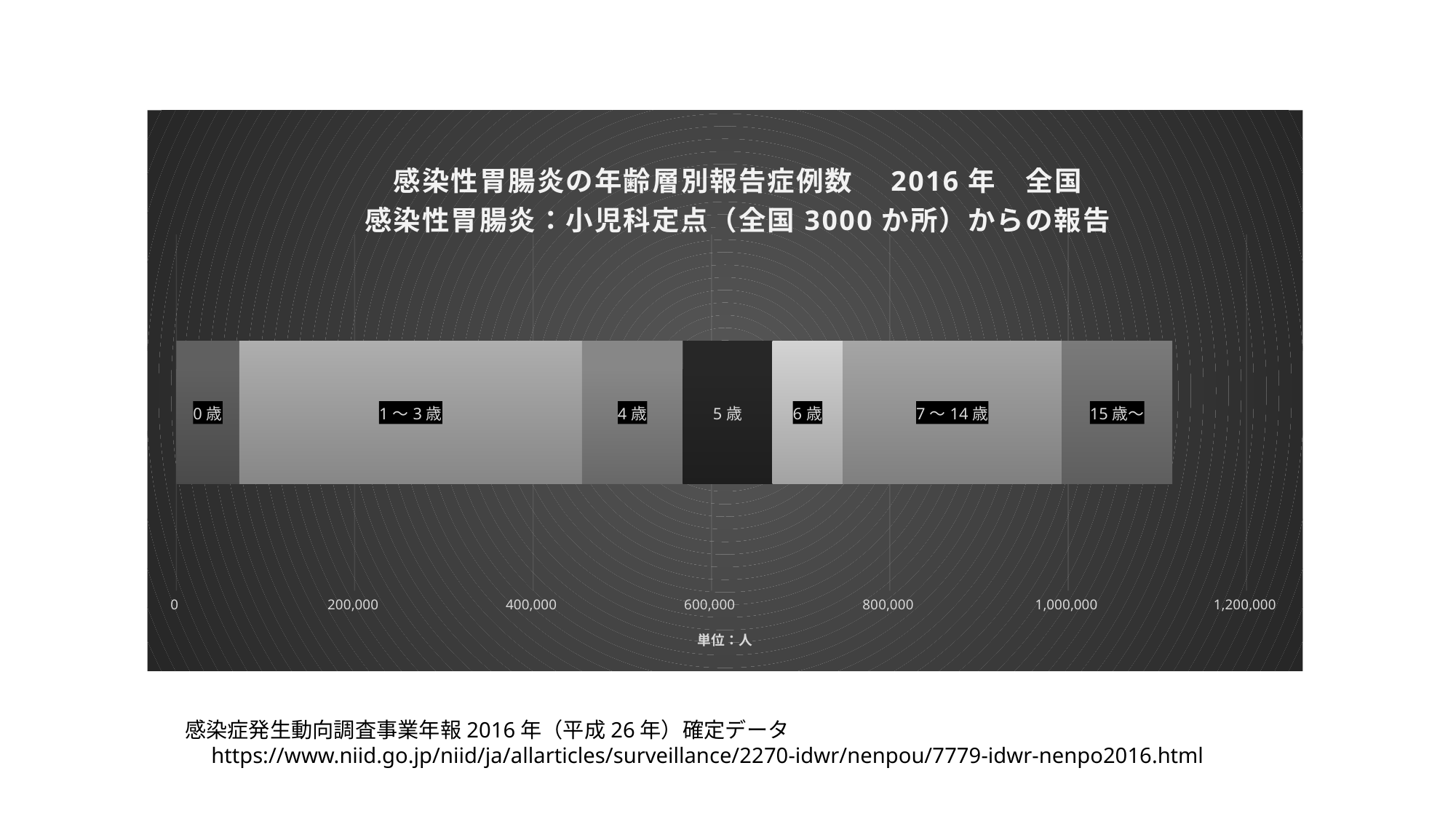
Is the total length of the stacked bar greater or less than 1,200,000? less Which segment is larger, 7～14歳 or 15歳～? 7～14歳 Which age group has the smallest segment in the bar? 0歳 Which segment is larger, 4歳 or 6歳? 4歳 What unit is indicated below the axis? 単位：人 What is the highest value shown on the horizontal axis? 1,200,000 Is the total length of the stacked bar greater or less than 1,000,000? greater How many age-group segments make up the stacked bar? 7 Which segment is larger, 1～3歳 or 7～14歳? 1～3歳 What kind of chart is shown on the slide? Stacked bar chart Which age group has the largest segment in the bar? 1～3歳